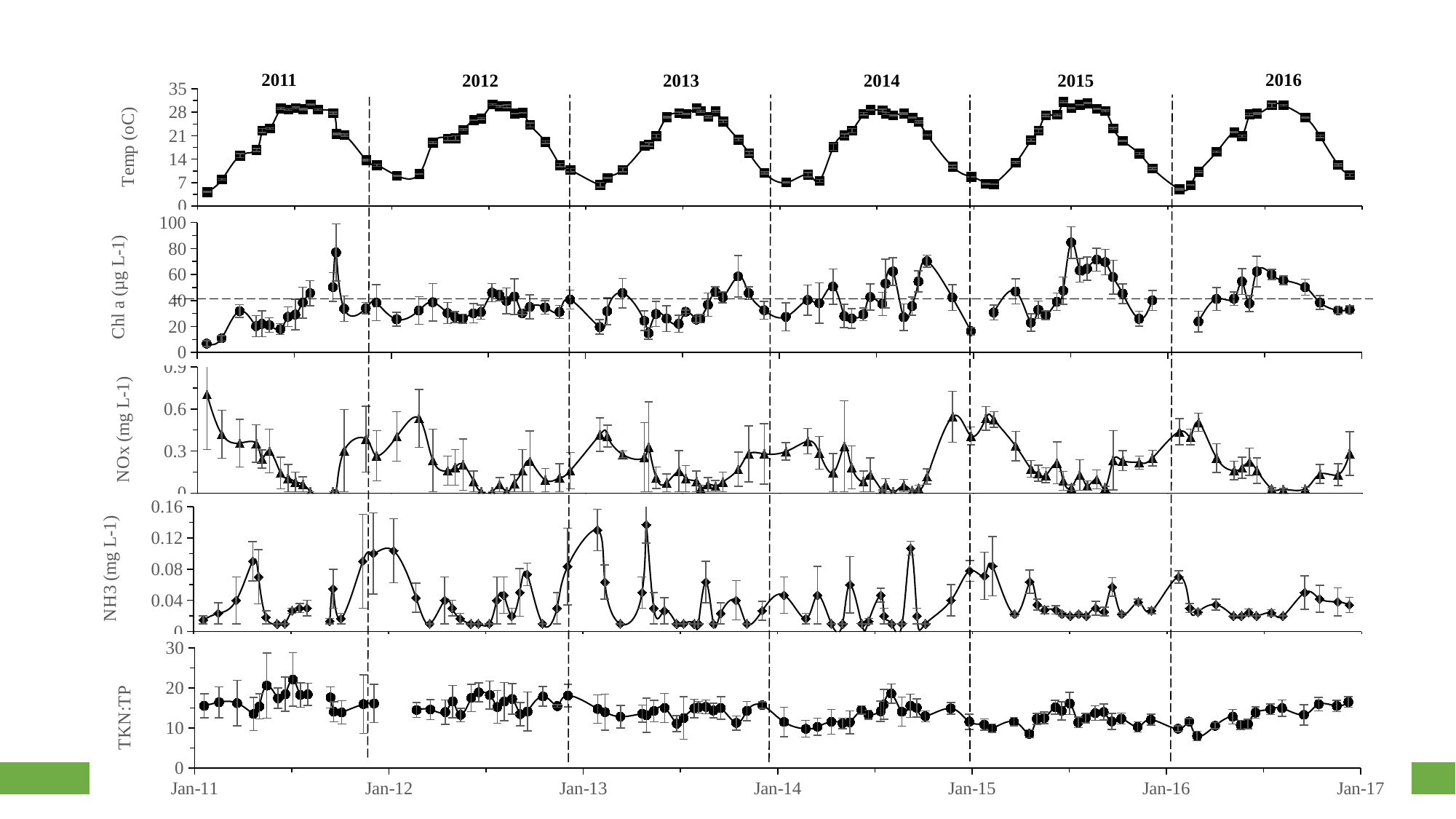
What kind of chart is used in the top panel labelled Temp (oC)? line chart Is the peak temperature in 2015 greater or less than 28? greater In the TKN:TP panel, is the lowest value in early 2016 greater or less than 10? less Does the temperature rise or fall from Jan-11 to the middle of 2011? rise Which variable is plotted in the bottom panel? TKN:TP How many years are labelled across the top of the chart? 6 In the NH3 panel, which is larger: the peak in 2013 or the peak in 2016? 2013 In the Chl a panel, is the highest value in 2015 greater or less than 60? greater How many stacked panels (variables) are plotted on the slide? 5